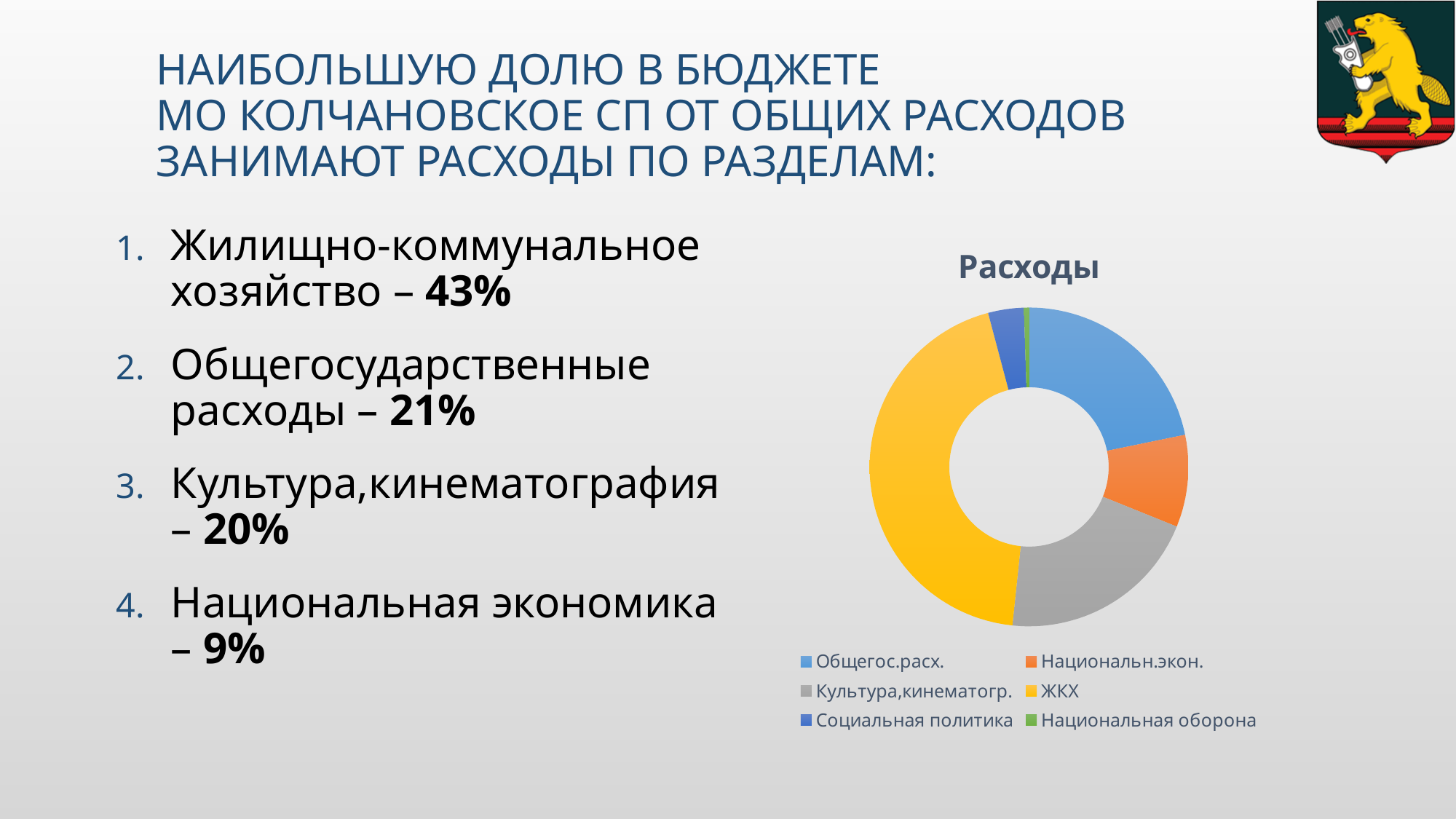
What share of expenses does ЖКХ (Жилищно-коммунальное хозяйство) account for, according to the slide? 43% What is the title of the chart? Расходы How many categories does the chart's legend list? 6 By how many percentage points does the ЖКХ share exceed the Общегос.расх. share, according to the slide? 22% Which category has the smallest slice in the chart? Национальная оборона Which slice is larger: Социальная политика or Национальная оборона? Социальная политика What colour is the ЖКХ slice in the chart? Yellow What kind of chart is shown on the slide? Doughnut (pie) chart Which slice is larger: ЖКХ or Общегос.расх.? ЖКХ Which category has the largest slice in the chart? ЖКХ Which slice is larger: Культура,кинематогр. or Национальн.экон.? Культура,кинематогр. What share of expenses does Национальн.экон. (Национальная экономика) account for, according to the slide? 9%